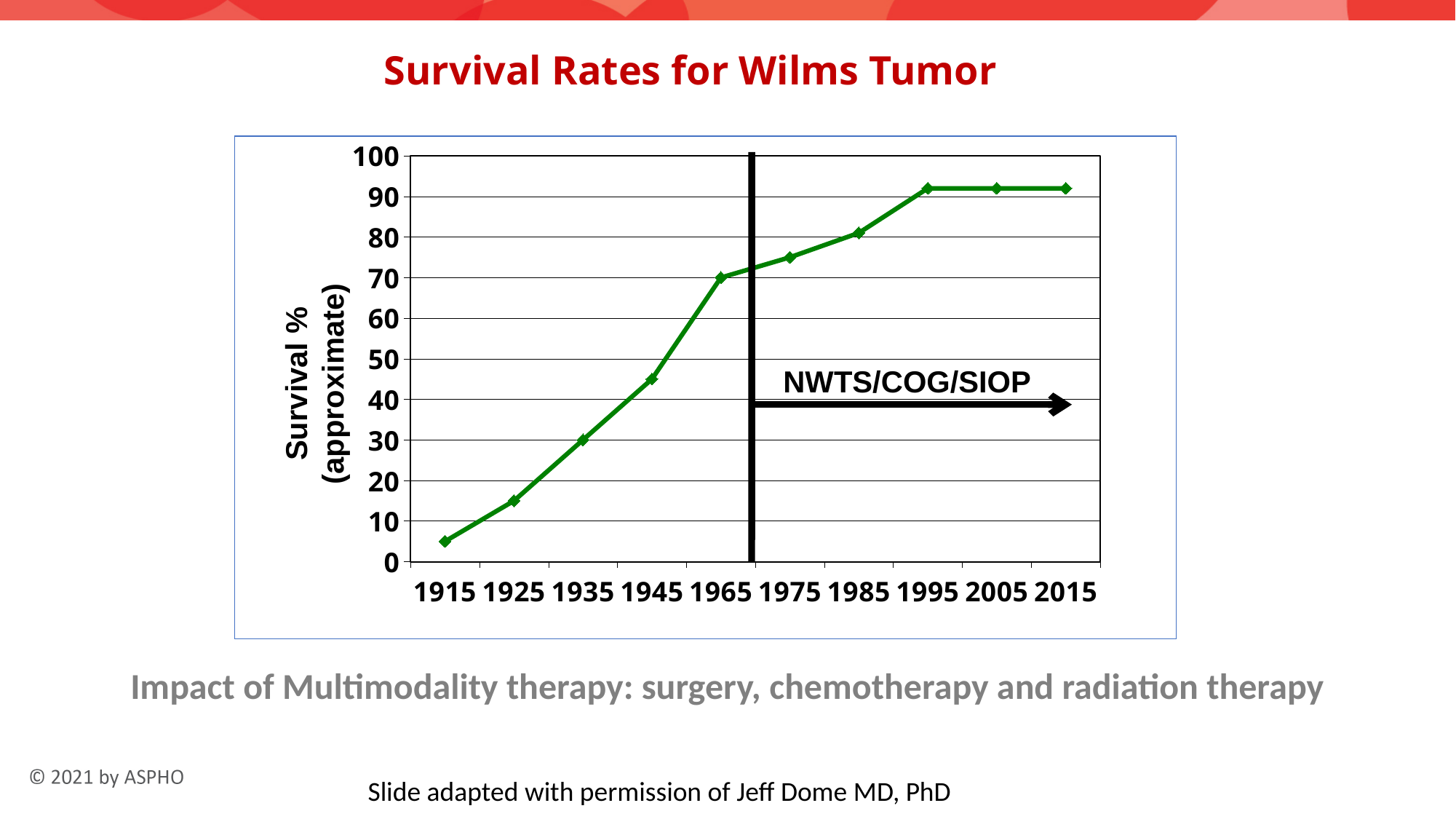
Is the value for 2015 greater or less than 90? greater What text appears next to the arrow inside the chart? NWTS/COG/SIOP Do survival rates rise or fall from 1915 to 2015? rise Which year has the larger survival percentage, 1945 or 1965? 1965 What is the survival percentage for 1965? 70 What is the survival percentage for 1935? 30 What kind of chart is shown on the slide? line chart What is the label on the vertical axis? Survival % (approximate) Which year has the lowest survival percentage? 1915 Is the value for 1915 greater or less than 10? less Is the value for 1945 greater or less than 40? greater How many data points are plotted on the line? 10